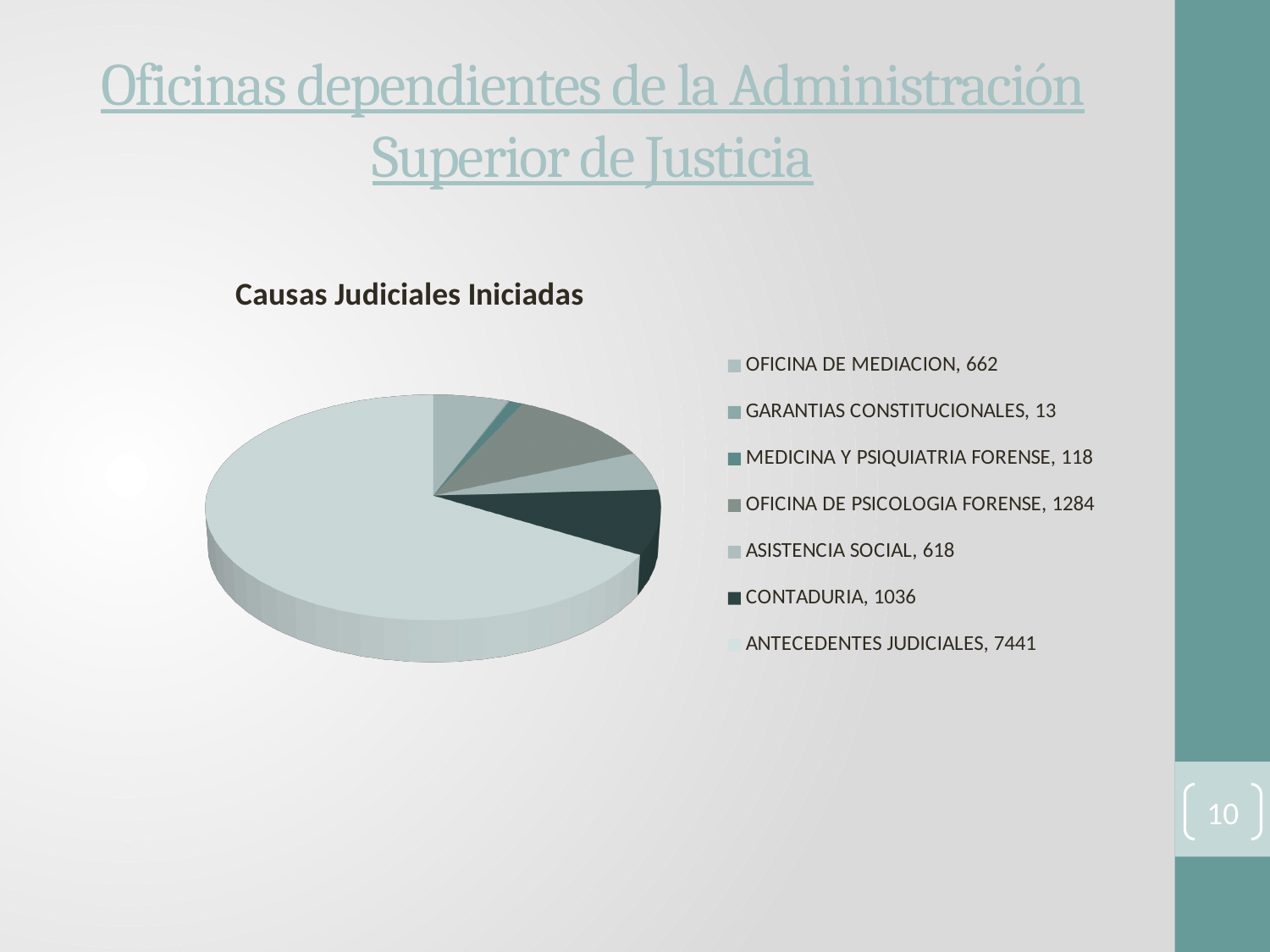
What is the value for CONTADURIA? 1036 What is the total of all the values shown in the pie chart? 11172 What type of chart is shown on the slide? Pie chart Which category has the lowest value? GARANTIAS CONSTITUCIONALES Which category has the highest value? ANTECEDENTES JUDICIALES What is the difference between OFICINA DE MEDIACION and ASISTENCIA SOCIAL? 44 What is the value for OFICINA DE MEDIACION? 662 How many categories does the pie chart show? 7 What is the value for MEDICINA Y PSIQUIATRIA FORENSE? 118 What is the title of the chart? Causas Judiciales Iniciadas What is the difference between OFICINA DE PSICOLOGIA FORENSE and CONTADURIA? 248 Which is larger, CONTADURIA or OFICINA DE PSICOLOGIA FORENSE? OFICINA DE PSICOLOGIA FORENSE